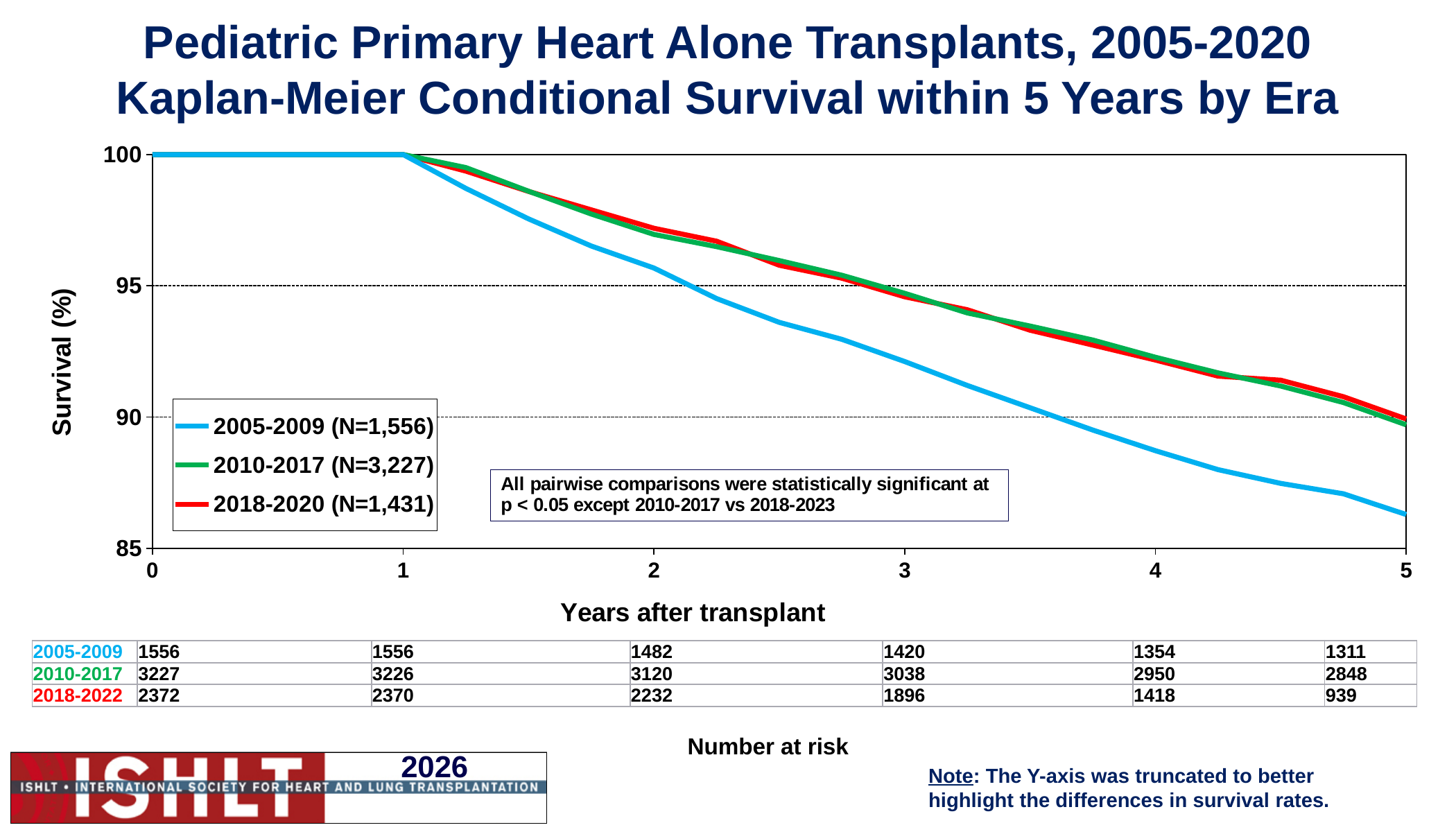
In the number at risk table, how many 2005-2009 patients are at risk at year 5? 1311 How many series does the legend list? 3 What kind of chart is shown on the slide? line chart Do the survival curves rise or fall as years after transplant increase? fall In the number at risk table, what is the difference between the 2010-2017 number at risk at year 0 and at year 5? 379 Is the survival for the 2018-2020 era at 2 years after transplant greater or less than 95? greater What is the N for the 2018-2020 era shown in the legend? 1,431 What is the N for the 2010-2017 era shown in the legend? 3,227 In the number at risk table, how many 2010-2017 patients are at risk at year 3? 3038 What is the label of the y axis? Survival (%) Is the survival for the 2005-2009 era at 5 years after transplant greater or less than 90? less Which era has the lowest survival at 5 years after transplant? 2005-2009